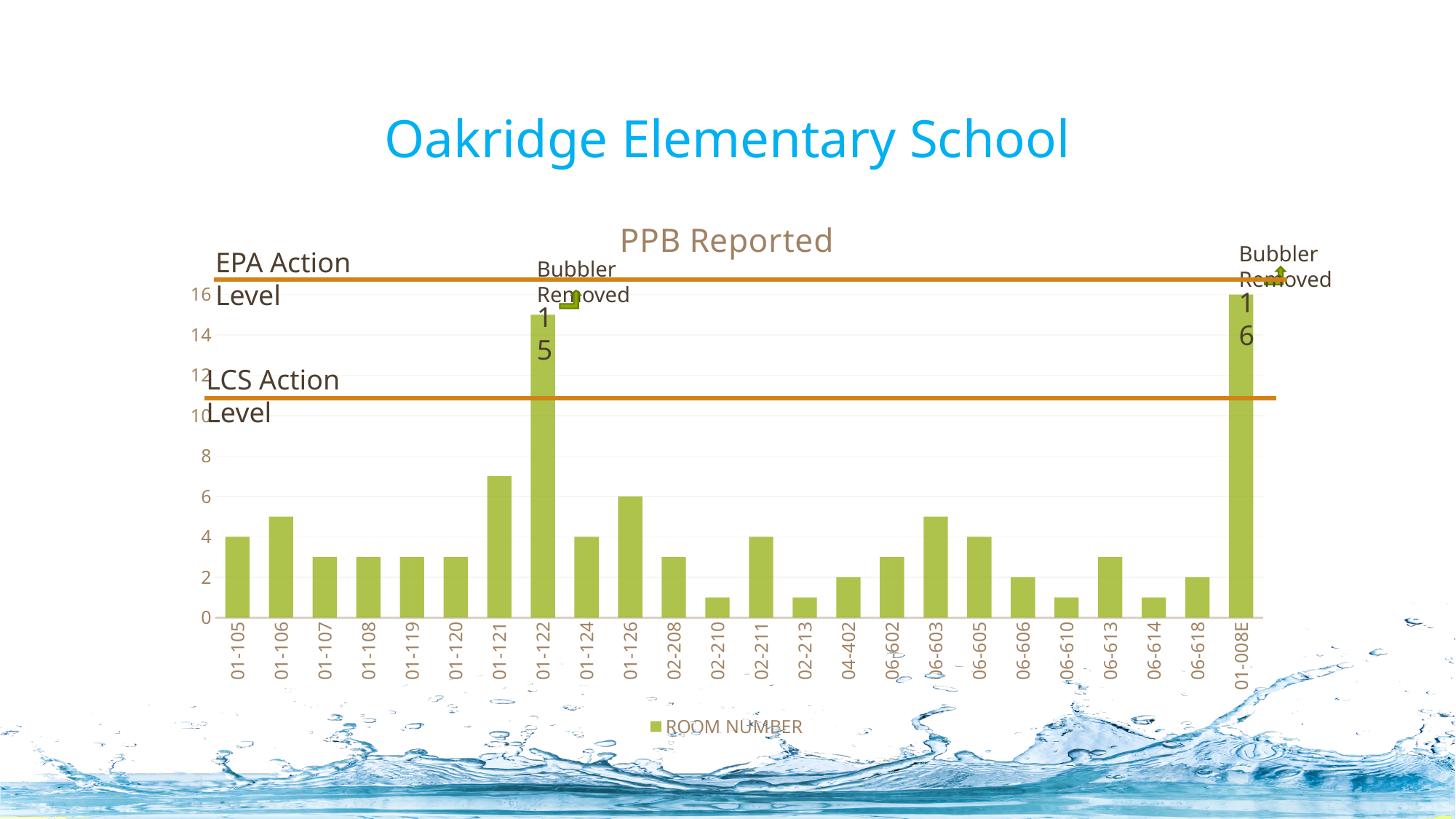
What is the title of the chart? PPB Reported Is the PPB value for room 01-122 greater or less than 10? greater What is the PPB value reported for room 01-122? 15 Which room has the larger PPB value, 01-121 or 01-126? 01-121 Is the PPB value for room 01-121 greater or less than 8? less Which room has the highest PPB reported value? 01-008E What is the name of the series shown in the legend? ROOM NUMBER How many series does the legend list? 1 What is the difference between the PPB values for 01-008E and 01-122? 1 How many rooms are shown on the x axis of the chart? 24 What is the PPB value reported for room 01-008E? 16 What type of chart is shown on the slide? bar chart